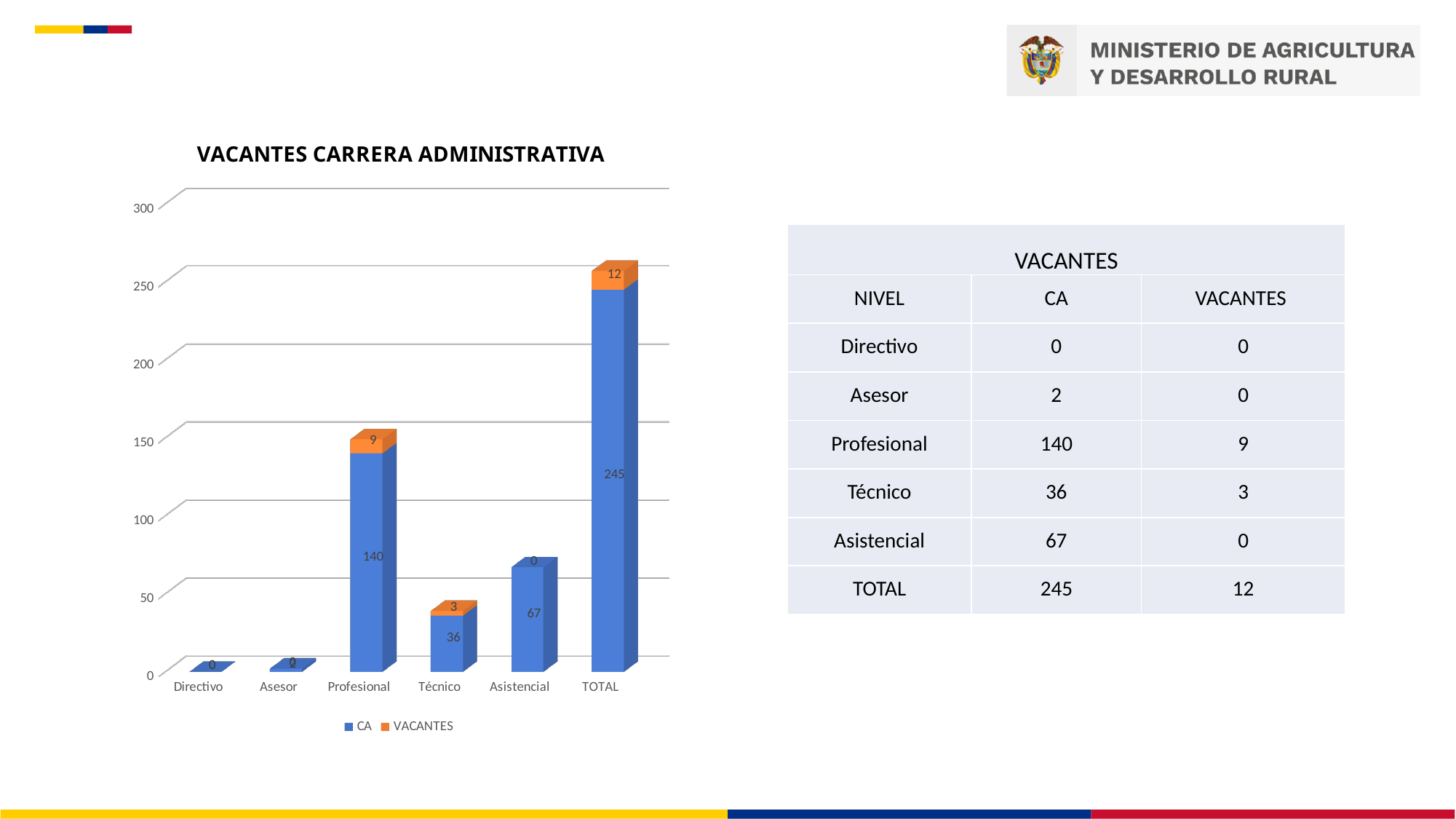
What is the title of the chart? VACANTES CARRERA ADMINISTRATIVA What is the VACANTES value for TOTAL? 12 What is the CA value for Asistencial? 67 How many series does the chart legend list? 2 Excluding TOTAL, which category has the highest CA value? Profesional Which has a larger CA value, Asistencial or Técnico? Asistencial What is the VACANTES value for Técnico? 3 How many categories are shown on the x axis of the chart? 6 What kind of chart is shown on the slide? bar chart What is the difference between the CA values for Profesional and Técnico? 104 What is the CA value for Profesional? 140 What is the total height of the stacked bar for Profesional (CA plus VACANTES)? 149